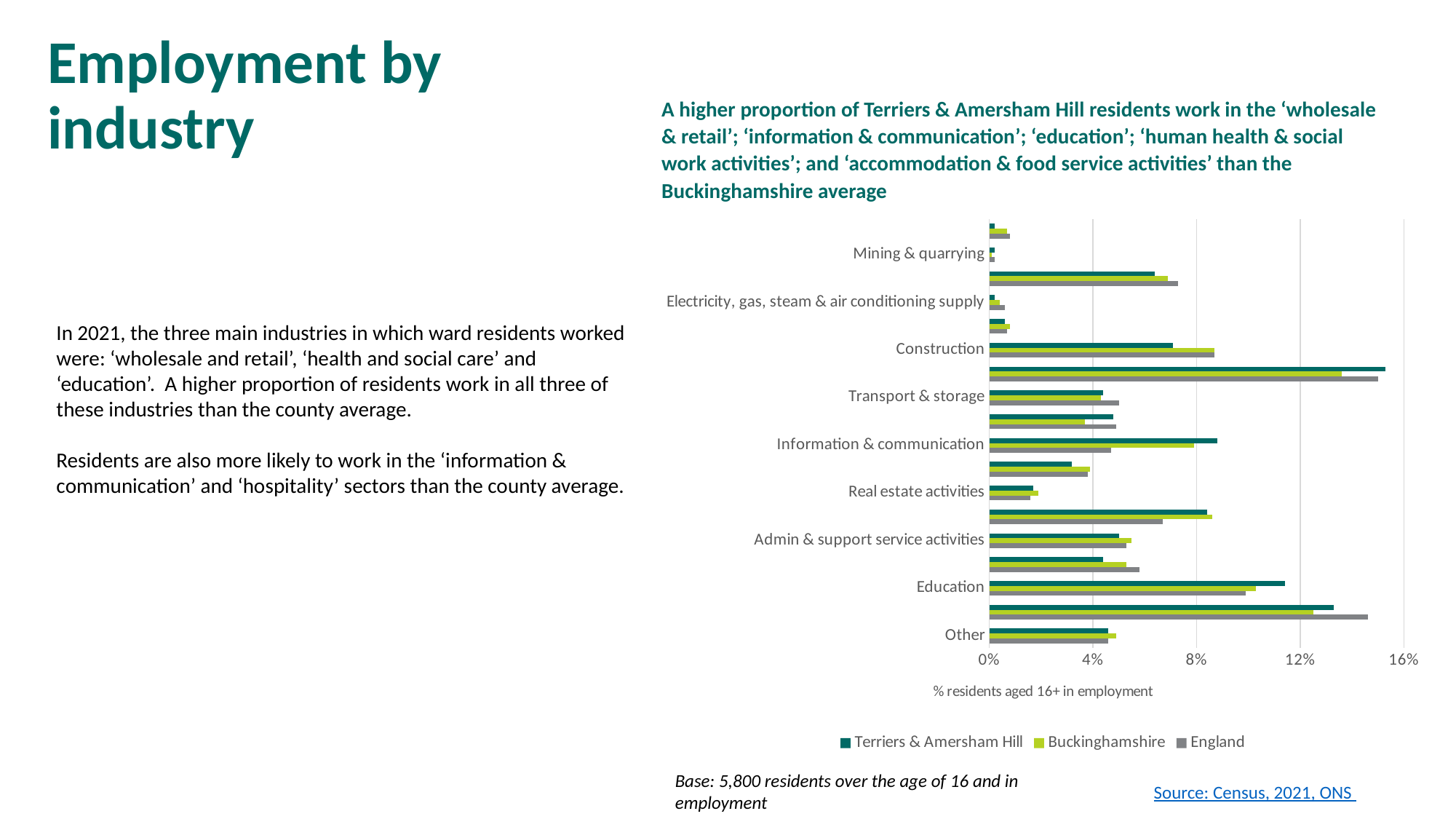
Is the Terriers & Amersham Hill value for Information & communication greater or less than 8%? greater For Information & communication, which is larger: the Terriers & Amersham Hill value or the England value? Terriers & Amersham Hill Is the Terriers & Amersham Hill value for Real estate activities greater or less than 4%? less What is the title of the chart's horizontal axis? % residents aged 16+ in employment Is the Terriers & Amersham Hill value for Education greater or less than 8%? greater For Construction, which is larger: the Terriers & Amersham Hill value or the England value? England How many series does the chart legend list? 3 What kind of chart is shown on the slide? bar chart